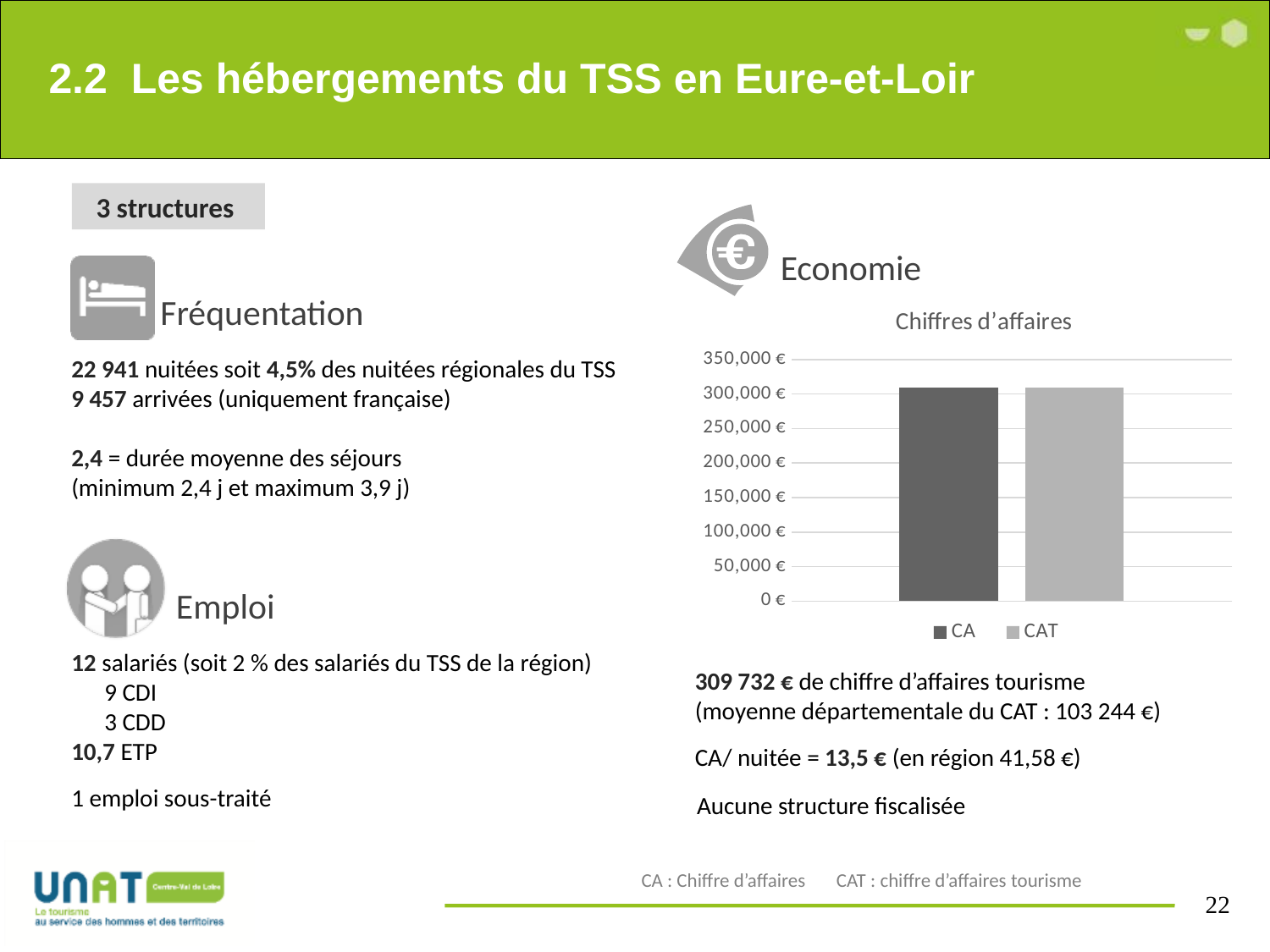
What is the title of the chart on the slide? Chiffres d'affaires Is the value for CAT in the "Chiffres d'affaires" chart greater or less than 350,000 €? less Is the value for CA in the "Chiffres d'affaires" chart greater or less than 250,000 €? greater What is the highest value shown on the y axis of the "Chiffres d'affaires" chart? 350,000 € How many series does the legend of the "Chiffres d'affaires" chart list? 2 Is the value for CAT in the "Chiffres d'affaires" chart greater or less than 200,000 €? greater What kind of chart is shown under the title "Chiffres d'affaires"? bar chart How many bars are plotted in the "Chiffres d'affaires" chart? 2 Which legend entries are shown in the "Chiffres d'affaires" chart? CA and CAT